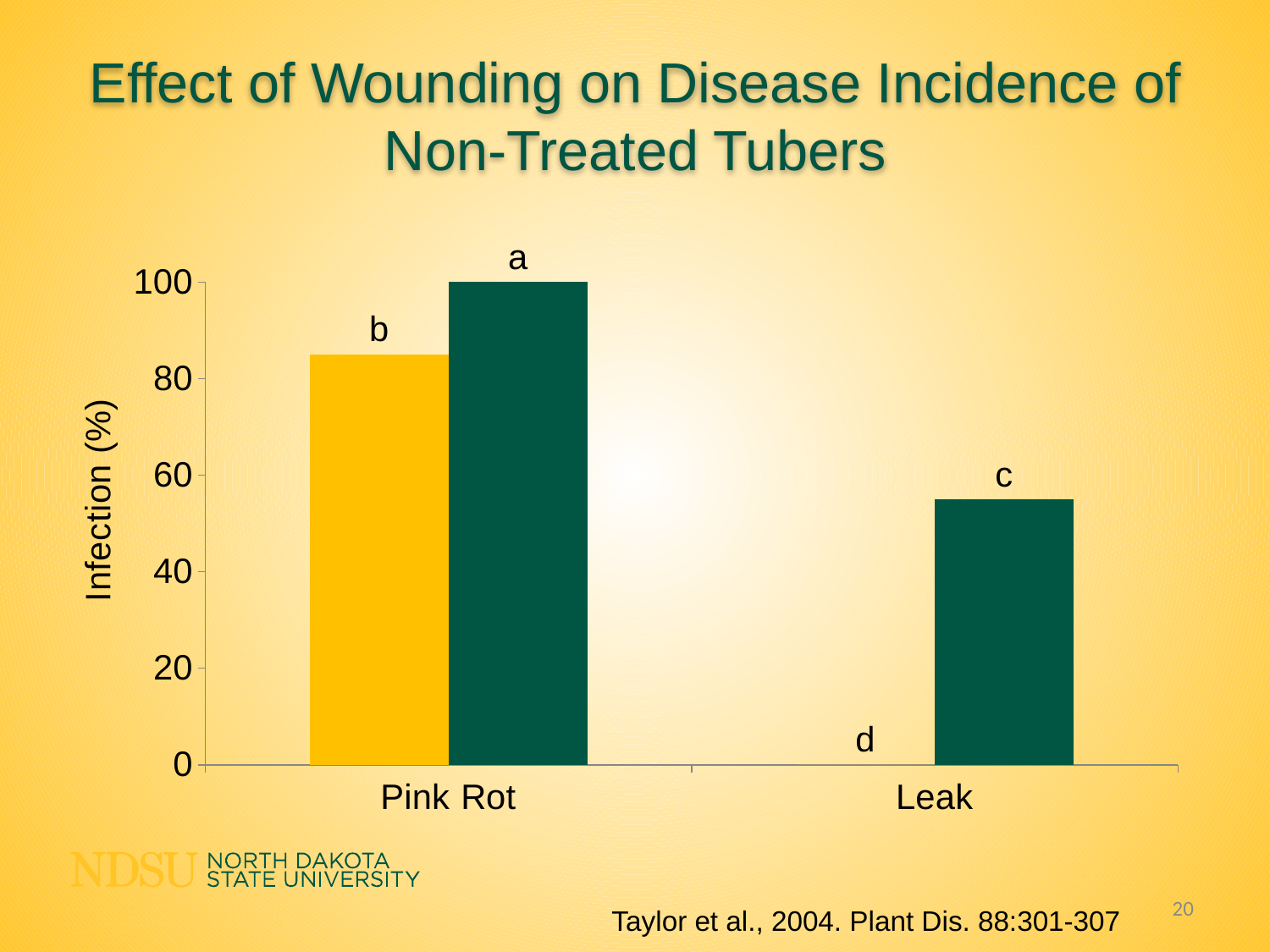
For the dark green bars, which category has the larger infection percentage, Pink Rot or Leak? Pink Rot Is the value for the dark green bar in the Leak category greater or less than 60? less How many disease categories are shown on the x axis? 2 Which bar has the highest infection percentage? the dark green bar for Pink Rot What is the infection percentage for the dark green bar in the Pink Rot category? 100 What kind of chart is shown on the slide? bar chart What is the title of the y axis? Infection (%) Which bar has the lowest infection percentage? the yellow bar for Leak What letter is printed above the dark green bar in the Pink Rot category? a Is the value for the yellow bar in the Pink Rot category greater or less than 80? greater What is the infection percentage for the yellow bar in the Leak category? 0 In the Pink Rot category, which bar is taller, the yellow bar or the dark green bar? the dark green bar